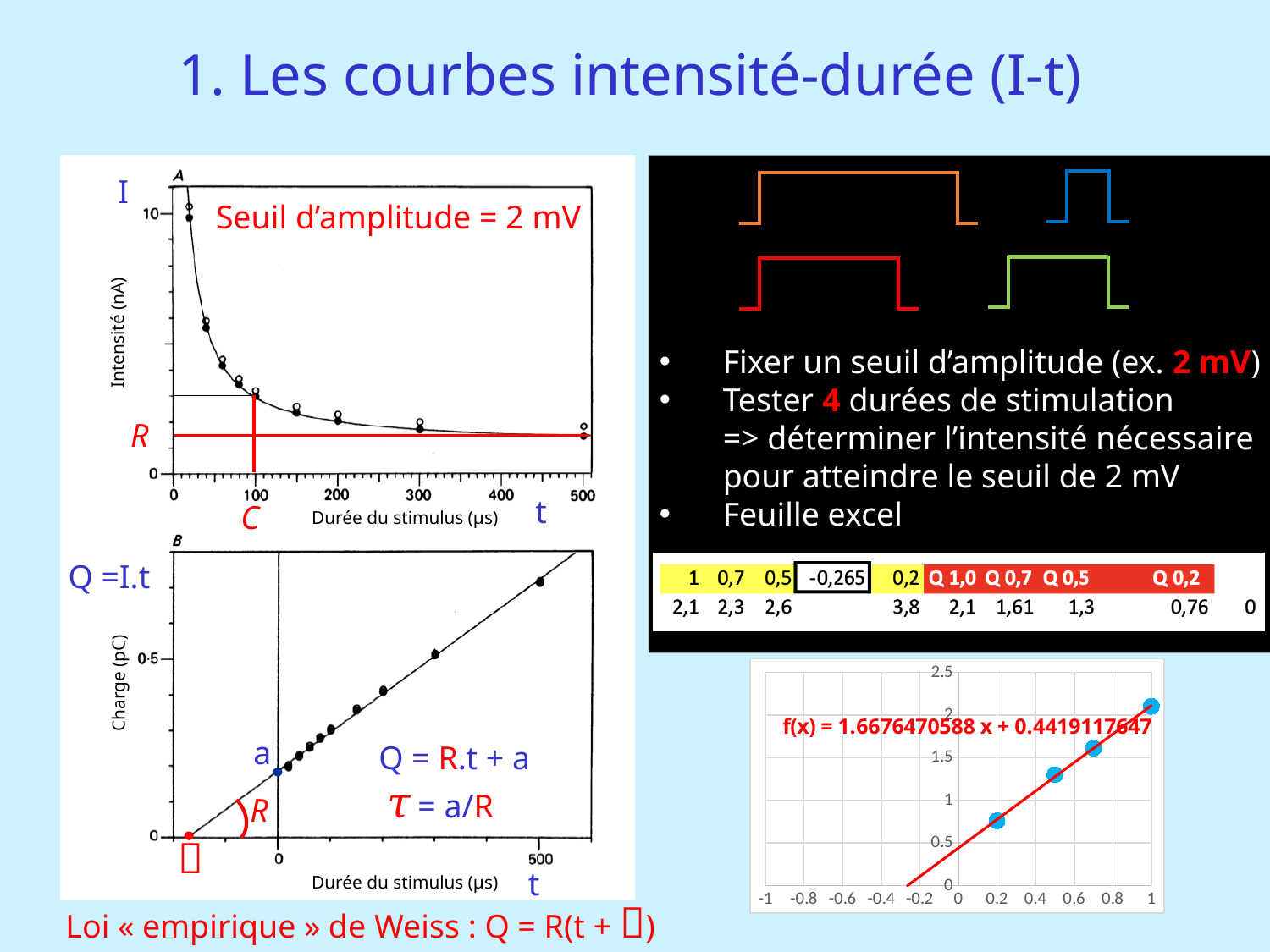
In chart A at the top left, is the intensity at a stimulus duration of 100 µs greater or less than 10 nA? less In the Excel scatter chart at the bottom right, is the value of the point at x = 0.2 greater or less than 1? less What kind of chart is the Excel chart at the bottom right of the slide? scatter chart In chart B at the bottom left (Charge vs Durée du stimulus), does the charge rise or fall as the stimulus duration increases? rise In the Excel scatter chart at the bottom right, at which x value is the highest plotted point? 1 In the Excel scatter chart at the bottom right, is the value of the point at x = 0.5 greater or less than 1? greater In chart A at the top left (Intensité vs Durée du stimulus), does the intensity rise or fall as the stimulus duration increases? fall What is the trendline equation shown on the Excel scatter chart at the bottom right? f(x) = 1.6676470588 x + 0.4419117647 What is the y-axis label of chart B at the bottom left? Charge (pC) How many data points are plotted in the Excel scatter chart at the bottom right? 4 In the Excel scatter chart at the bottom right, do the values rise or fall as x increases? rise In the Excel scatter chart at the bottom right, what is the highest tick value shown on the y axis? 2.5